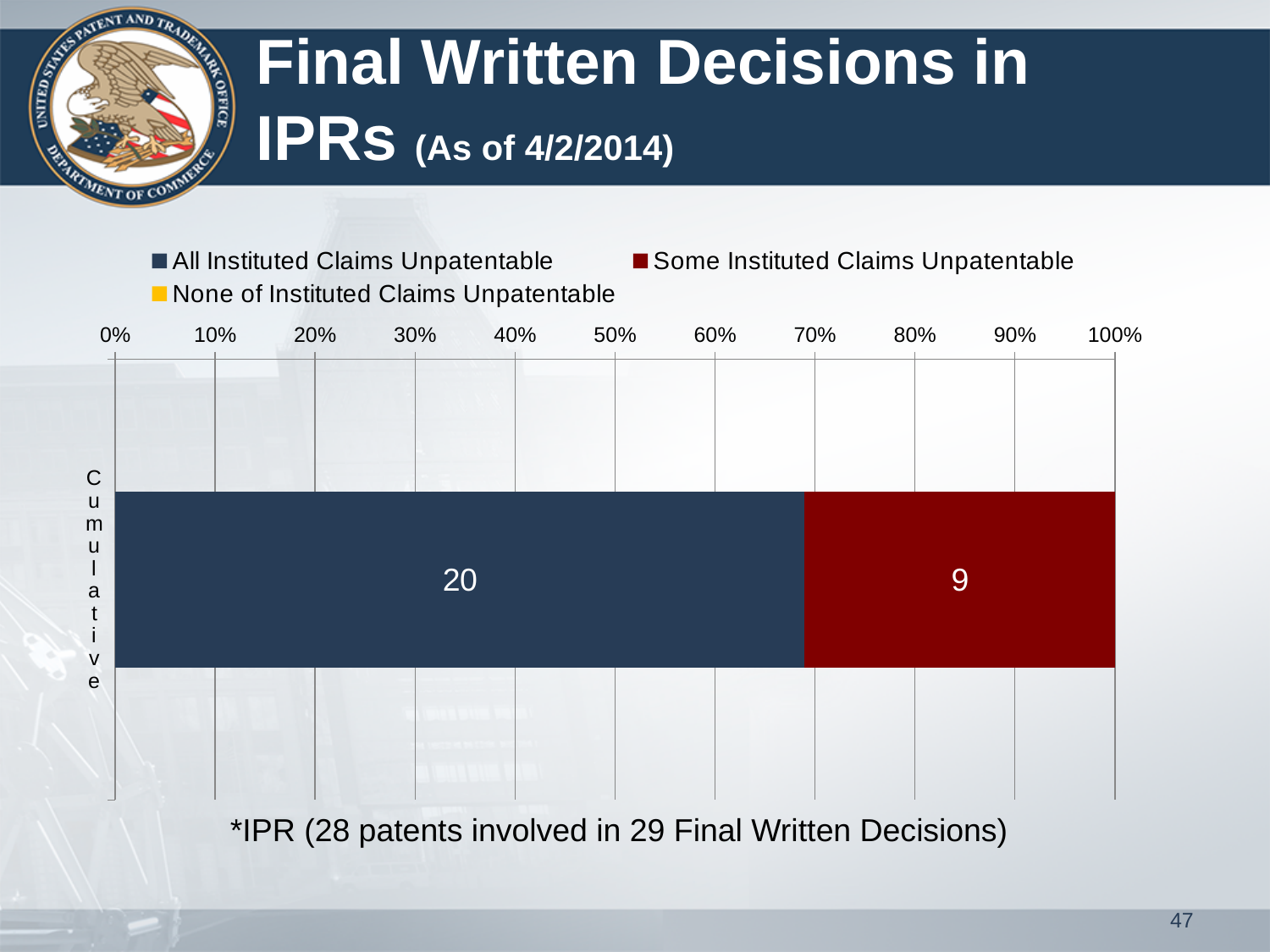
What is the total of the labelled segments in the Cumulative bar? 29 What kind of chart is shown on the slide? Stacked bar chart Which is larger: the value for All Instituted Claims Unpatentable or the value for Some Instituted Claims Unpatentable? All Instituted Claims Unpatentable Is the share of the bar for Some Instituted Claims Unpatentable greater or less than 40%? less Is the share of the bar for All Instituted Claims Unpatentable greater or less than 60%? greater Which series has the highest value in the Cumulative bar? All Instituted Claims Unpatentable What is the value for All Instituted Claims Unpatentable in the Cumulative bar? 20 What is the value for Some Instituted Claims Unpatentable in the Cumulative bar? 9 What colour represents Some Instituted Claims Unpatentable in the chart? Dark red How many series does the legend list? 3 How many categories are plotted on the chart? 1 What is the difference between the All Instituted Claims Unpatentable value and the Some Instituted Claims Unpatentable value? 11